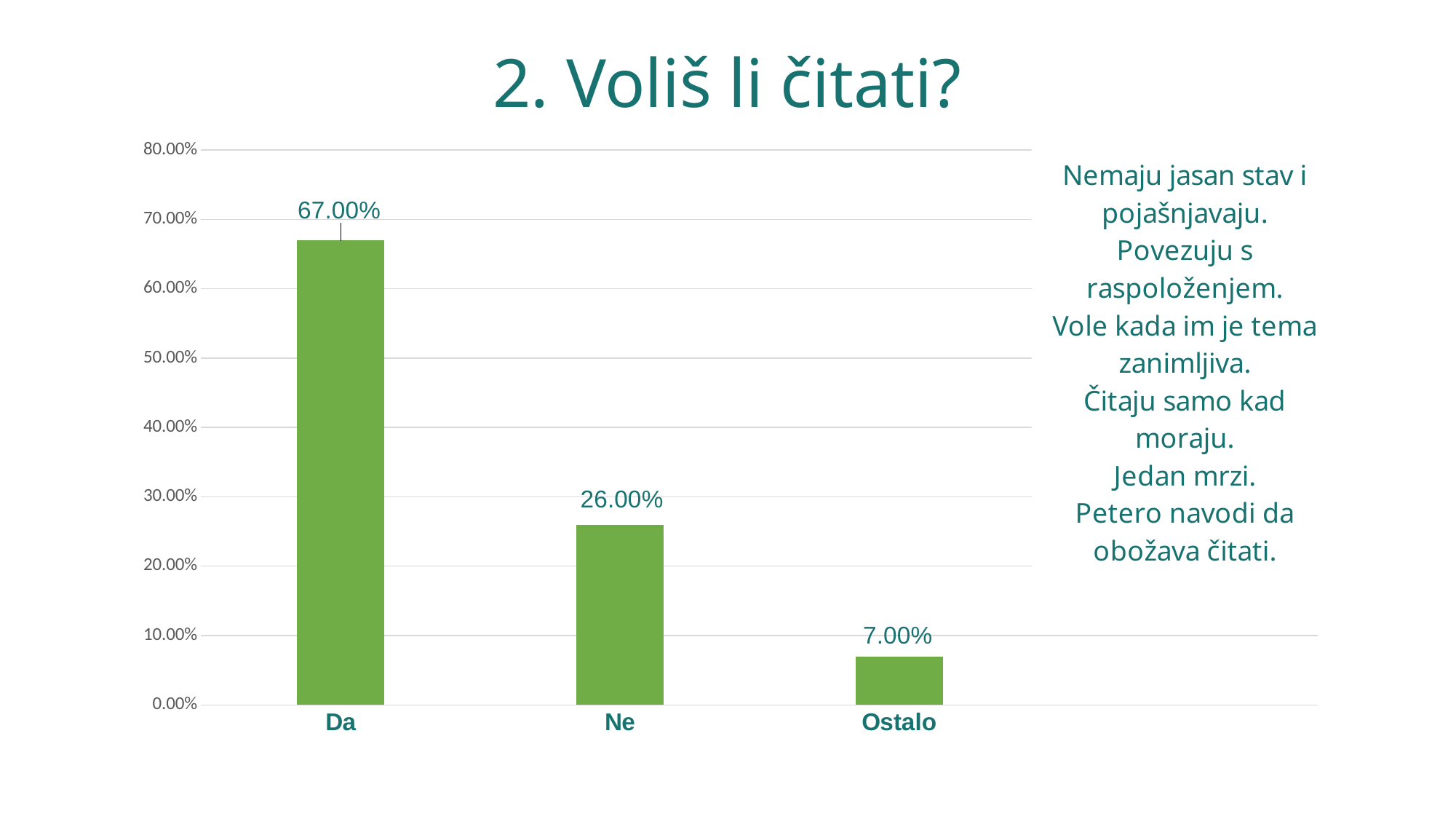
What is the value for Ostalo? 7.00% Which is larger, the value for Ne or the value for Ostalo? Ne Is the value for Da greater or less than 60.00%? greater Which category has the lowest value? Ostalo What is the value for Da? 67.00% What is the difference between the values for Ne and Ostalo? 19.00% What is the value for Ne? 26.00% How many categories are shown on the x axis? 3 Which category has the highest value? Da What is the difference between the values for Da and Ne? 41.00% What is the title of the slide containing the chart? 2. Voliš li čitati? What kind of chart is shown on the slide? bar chart